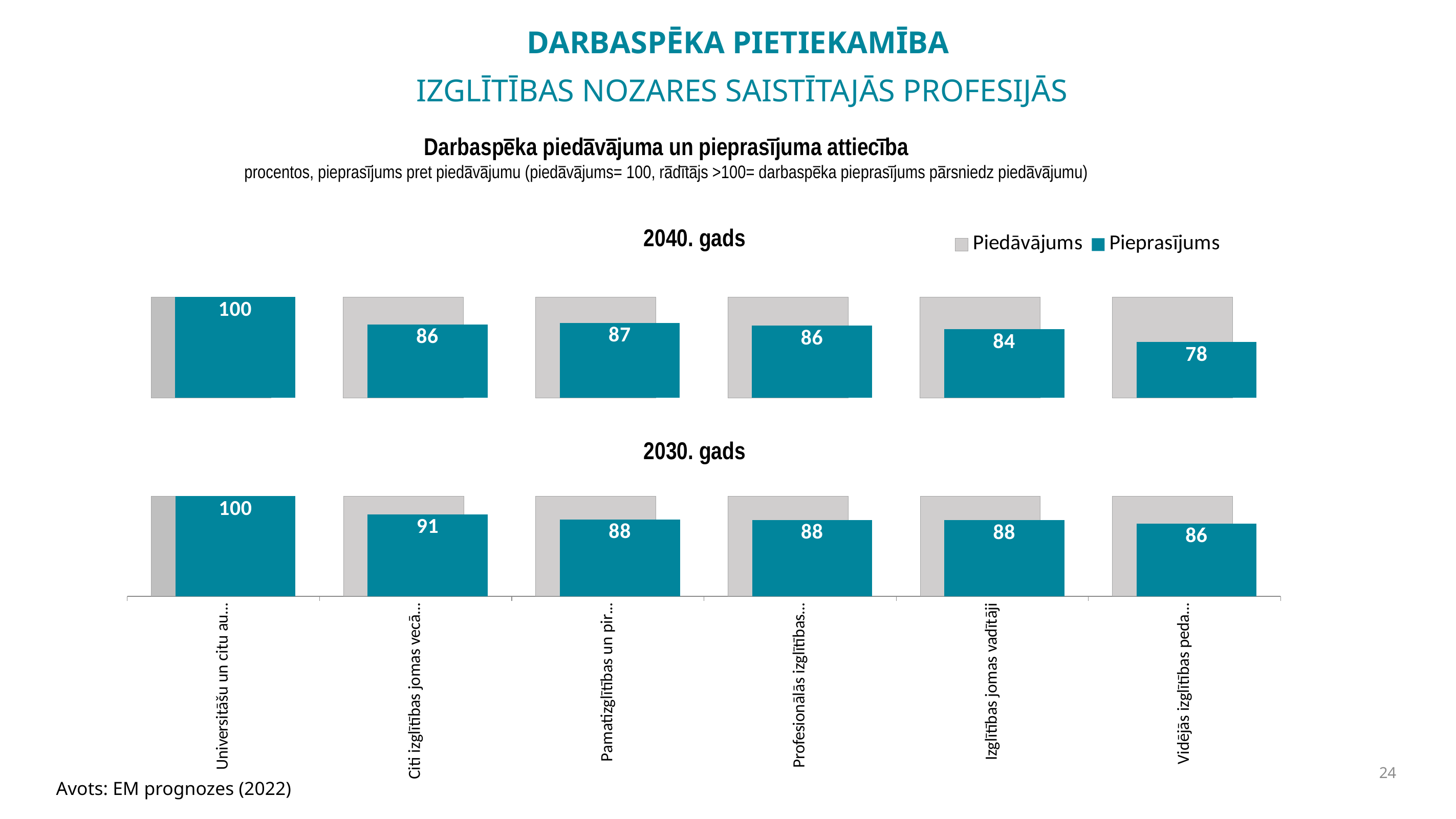
In the 2030. gads chart, what is the lowest Pieprasījums value shown? 86 What are the two entries in the legend? Piedāvājums and Pieprasījums In the 2030. gads chart, what is the highest Pieprasījums value shown? 100 How many categories are shown along the x axis of the 2030. gads chart? 6 In the 2040. gads chart, what is the difference between the Pieprasījums value of the first (leftmost) category and that of Izglītības jomas vadītāji? 16 In the 2030. gads chart, what is the Pieprasījums value for Izglītības jomas vadītāji? 88 What is the difference between the Pieprasījums value for Izglītības jomas vadītāji in the 2030. gads chart and in the 2040. gads chart? 4 In the 2040. gads chart, what is the lowest Pieprasījums value shown? 78 What kind of chart is the 2040. gads chart? bar chart How many series does the legend list? 2 In the 2040. gads chart, what is the Pieprasījums value for Izglītības jomas vadītāji? 84 In the 2040. gads chart, which has the larger Pieprasījums value: the first (leftmost) category or Izglītības jomas vadītāji? the first (leftmost) category